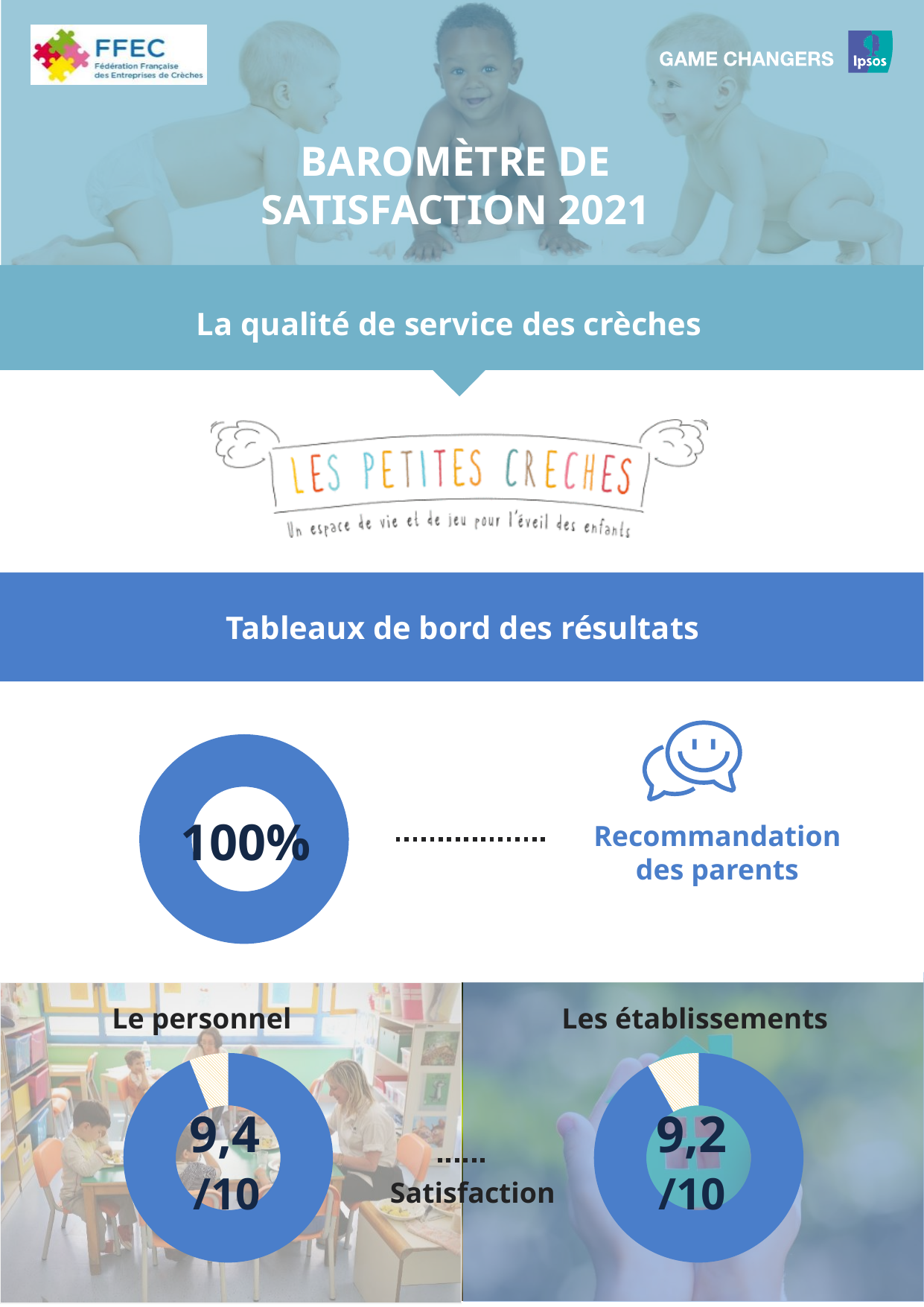
What label is written next to the 100% donut chart? Recommandation des parents What share of the 'Recommandation des parents' donut is filled? 100% Which of the three donut charts shows the lowest score? Les établissements What satisfaction score is shown in the 'Les établissements' donut chart? 9,2/10 How many donut charts are shown on the slide? 3 What kind of chart is used to show the 'Recommandation des parents' value? Donut chart What word appears between the 'Le personnel' and 'Les établissements' donut charts? Satisfaction What satisfaction score is shown in the 'Le personnel' donut chart? 9,4/10 Is the 'Le personnel' satisfaction score greater or less than 9/10? greater Which of the two satisfaction donut charts shows the higher score, 'Le personnel' or 'Les établissements'? Le personnel What value is shown in the centre of the 'Recommandation des parents' donut chart? 100% What is the difference between the 'Le personnel' score and the 'Les établissements' score? 0,2